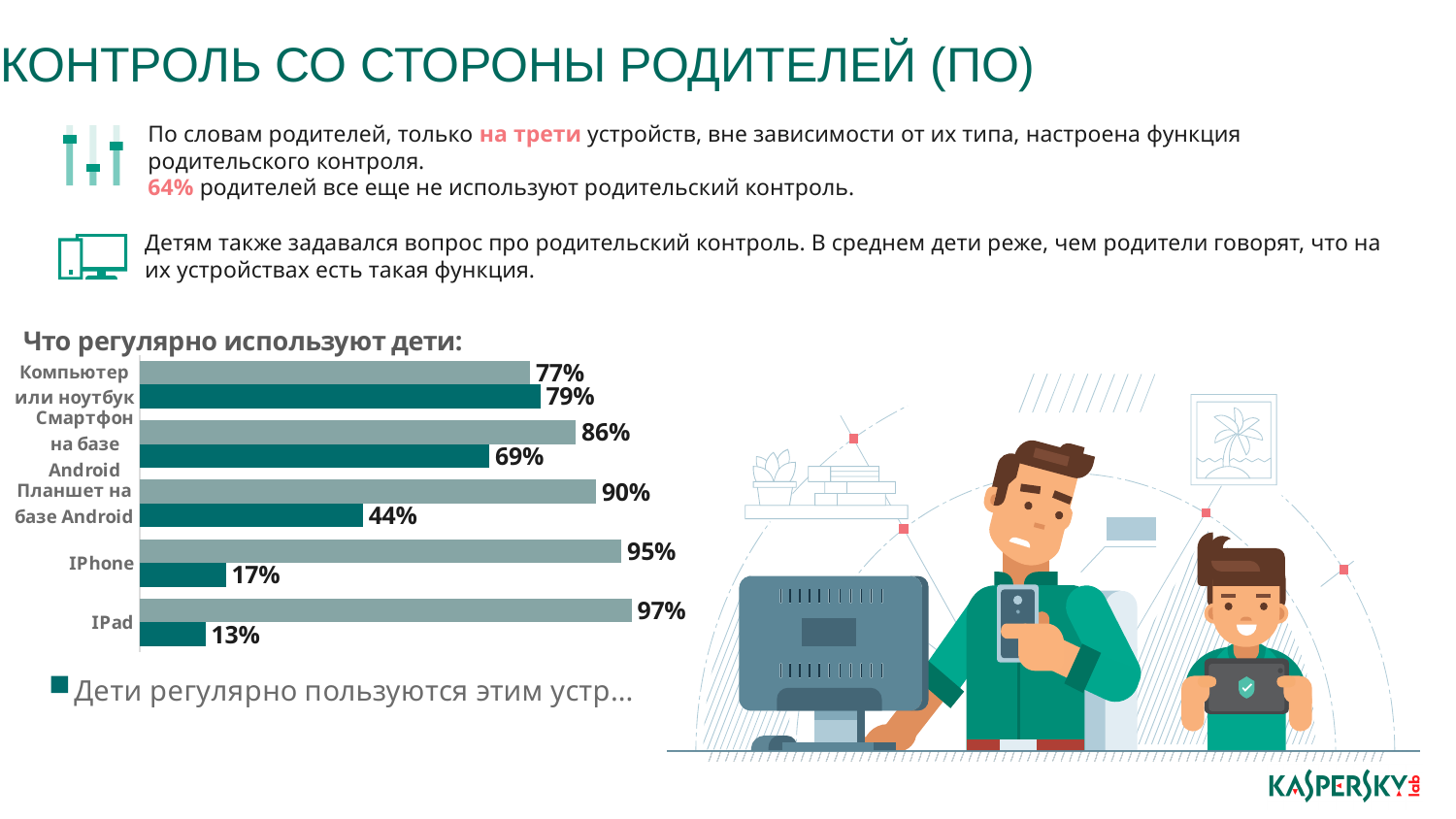
What is the value of the dark teal (lower) bar for IPhone? 17% What is the title shown above the bar chart? Что регулярно используют дети: What is the difference between the grey bar and the dark teal bar for IPhone? 78 percentage points What is the value of the dark teal (lower) bar for "Планшет на базе Android"? 44% Which category has the highest grey (upper) bar value? IPad What kind of chart is shown under the heading "Что регулярно используют дети:"? bar chart How many device categories are plotted in the chart? 5 Which category has the lowest dark teal (lower) bar value? IPad Do the grey (upper) bar values rise or fall going down the chart from "Компьютер или ноутбук" to IPad? rise Which has the larger dark teal (lower) bar value: "Компьютер или ноутбук" or "Смартфон на базе Android"? Компьютер или ноутбук What is the value of the grey (upper) bar for IPad? 97% What is the value of the grey (upper) bar for "Смартфон на базе Android"? 86%